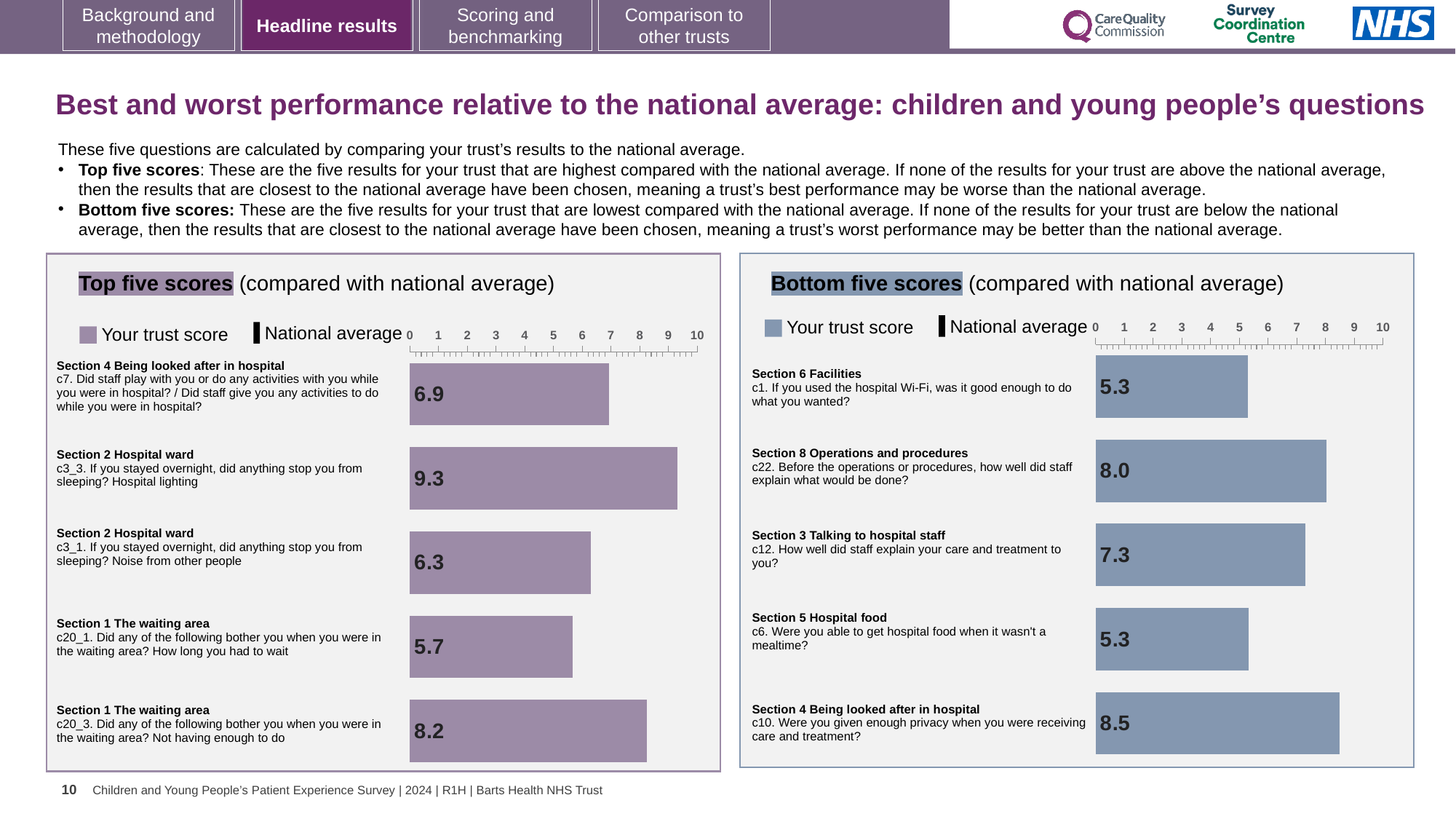
In the Top five scores chart, what is the trust score for c3_3 (hospital lighting stopping you from sleeping)? 9.3 In the Top five scores chart, which question has the highest trust score? c3_3. If you stayed overnight, did anything stop you from sleeping? Hospital lighting What type of chart is used in the Top five scores panel? Bar chart In the Top five scores chart, what is the trust score for c20_1 (how long you had to wait in the waiting area)? 5.7 In the Bottom five scores chart, what is the trust score for c22 (staff explaining what would be done before operations or procedures)? 8.0 In the Bottom five scores chart, what is the trust score for c10 (enough privacy when receiving care and treatment)? 8.5 How many questions are plotted in the Bottom five scores chart? 5 In the Bottom five scores chart, which question has the highest trust score? c10. Were you given enough privacy when you were receiving care and treatment? In the Top five scores chart, which question has the lowest trust score? c20_1. Did any of the following bother you when you were in the waiting area? How long you had to wait In the Bottom five scores chart, what is the difference between the trust scores for c10 (privacy) and c1 (hospital Wi-Fi)? 3.2 In the Bottom five scores chart, which has the larger trust score: c12 (how well staff explained your care and treatment) or c6 (hospital food when it wasn't a mealtime)? c12 In the Top five scores chart, what is the difference between the trust scores for c3_3 (hospital lighting) and c3_1 (noise from other people)? 3.0